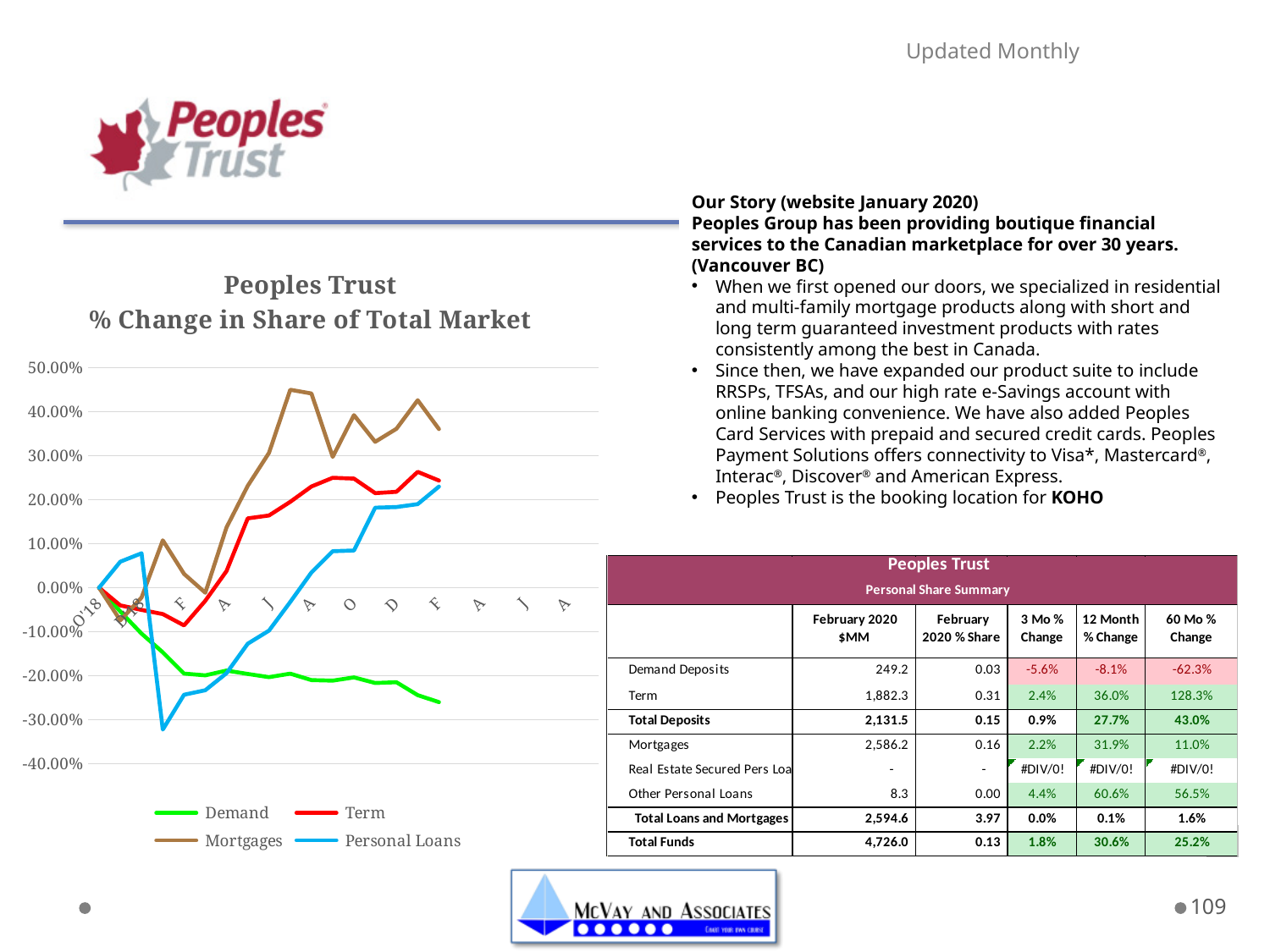
What is the title of the chart? Peoples Trust % Change in Share of Total Market At the right end of the chart, which is higher: the Mortgages line or the Term line? Mortgages What is the highest value shown on the chart's vertical axis? 50.00% What kind of chart is shown on the slide? line chart Is the peak value of the Mortgages line greater or less than 40.00%? greater Is the final value of the Demand line greater or less than -20.00%? less Is the lowest value of the Personal Loans line greater or less than -30.00%? less Does the Demand line generally rise or fall across the chart? fall Which series is drawn in green in the chart? Demand Which series reaches the highest value on the chart? Mortgages How many series does the chart legend list? 4 Which series reaches the lowest value on the chart? Personal Loans